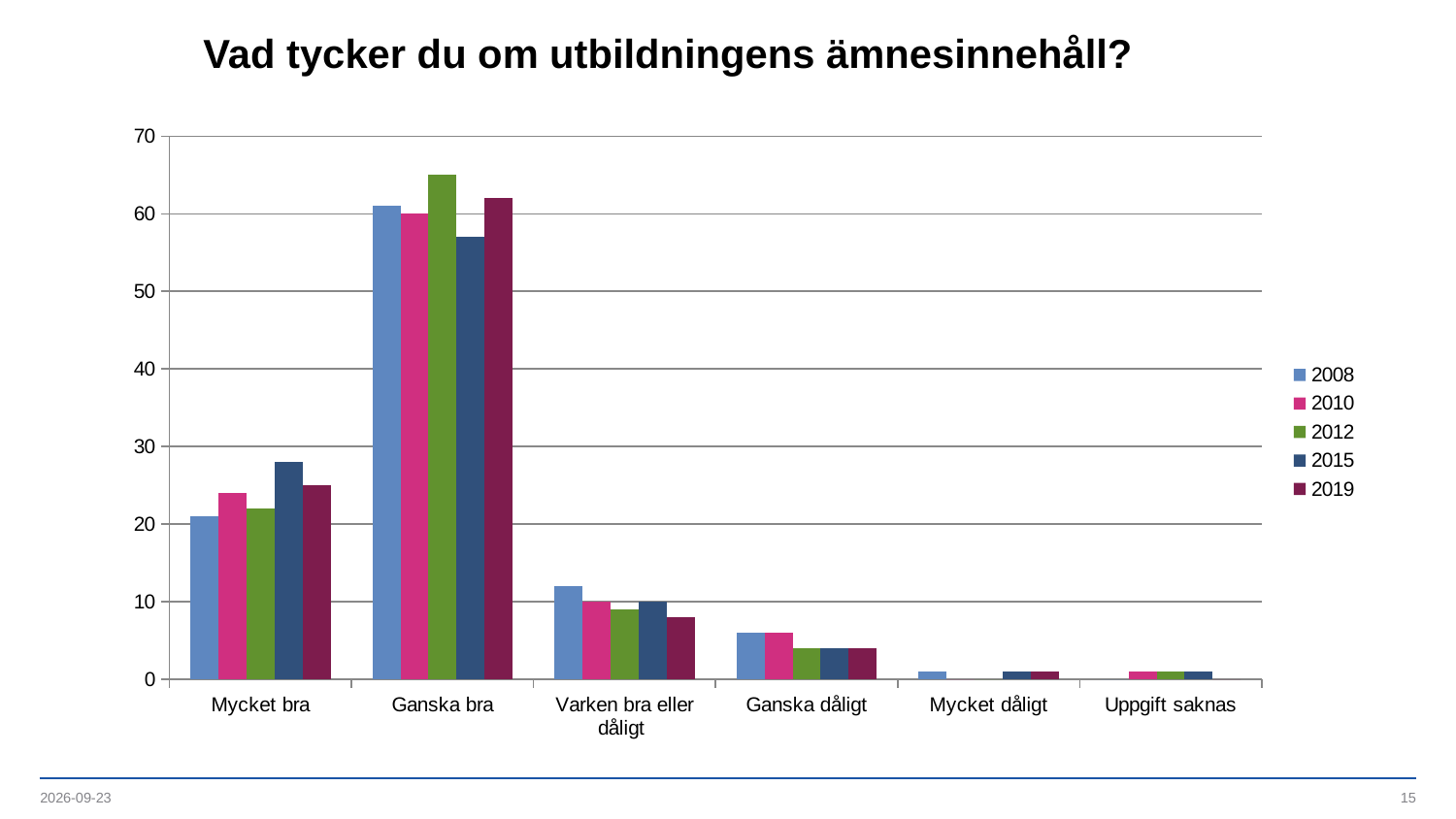
Is the value for 2012 in Ganska bra greater or less than 60? greater Which is larger in Ganska bra: the 2012 bar or the 2015 bar? 2012 How many categories are shown on the x axis? 6 Which category has the highest bars overall? Ganska bra Within the Ganska bra category, which year has the tallest bar? 2012 Is the value for 2015 in Mycket bra greater or less than 30? less What is the title of the chart? Vad tycker du om utbildningens ämnesinnehåll? Which is larger in Mycket bra: the 2008 bar or the 2015 bar? 2015 How many series does the legend list? 5 Is the value for 2008 in Ganska dåligt greater or less than 10? less What kind of chart is shown on the slide? bar chart Within the Mycket bra category, which year has the tallest bar? 2015